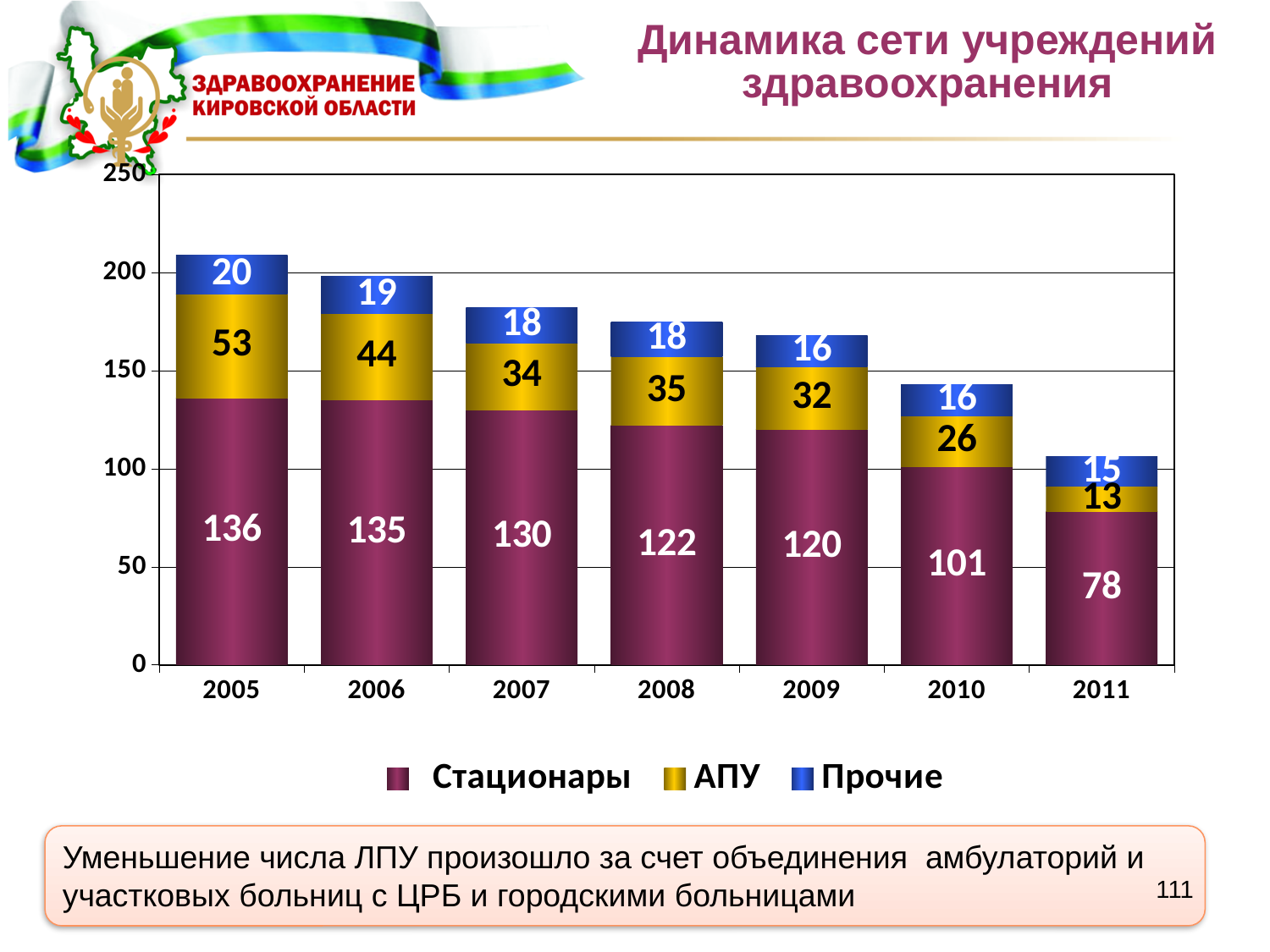
What is the total of the stacked bar for 2009? 168 How many series does the legend list? 3 Do the Стационары values rise or fall from 2005 to 2011? Fall What is the value for Прочие in 2005? 20 What type of chart is shown on the slide? Stacked bar chart Which is larger, the АПУ value for 2007 or for 2008? 2008 In which year is the value for Стационары the lowest? 2011 In which year is the value for АПУ the highest? 2005 What is the value for Стационары in 2007? 130 What is the difference between the Стационары values for 2005 and 2011? 58 What is the value for АПУ in 2010? 26 How many years are shown on the x axis? 7